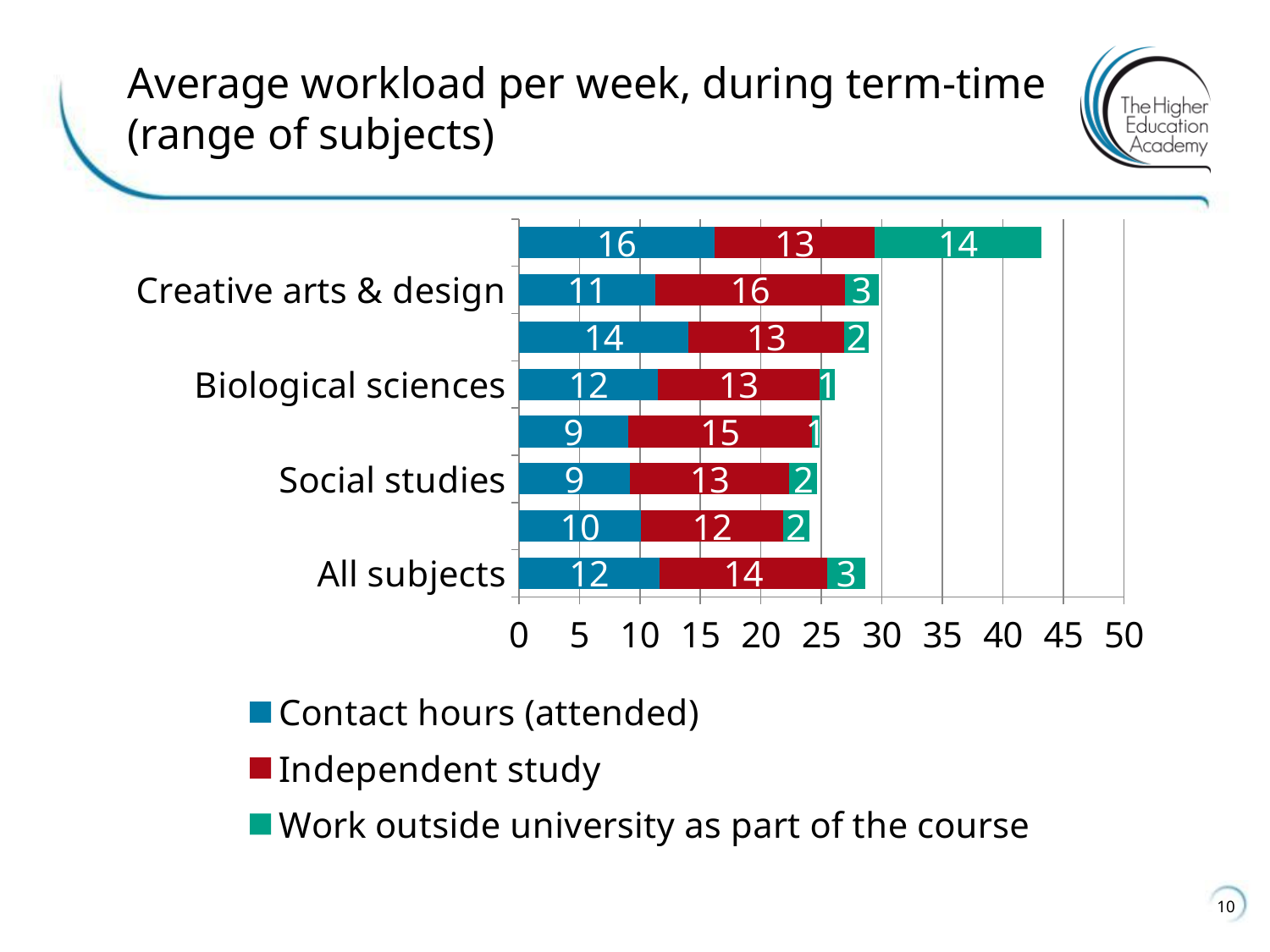
Which is larger: Contact hours (attended) for Biological sciences or Contact hours (attended) for Social studies? Biological sciences What is the value of Work outside university as part of the course for Biological sciences? 1 What type of chart is shown on the slide? bar chart What is the total of the stacked bar for Creative arts & design? 30 What is the value of Contact hours (attended) for Social studies? 9 How many bars are plotted in the chart? 8 How many series does the legend list? 3 What is the value of Contact hours (attended) for Creative arts & design? 11 What is the value of Independent study for Creative arts & design? 16 What is the total of the stacked bar for Social studies? 24 What is the value of Independent study for All subjects? 14 What is the difference between Independent study and Contact hours (attended) for Social studies? 4